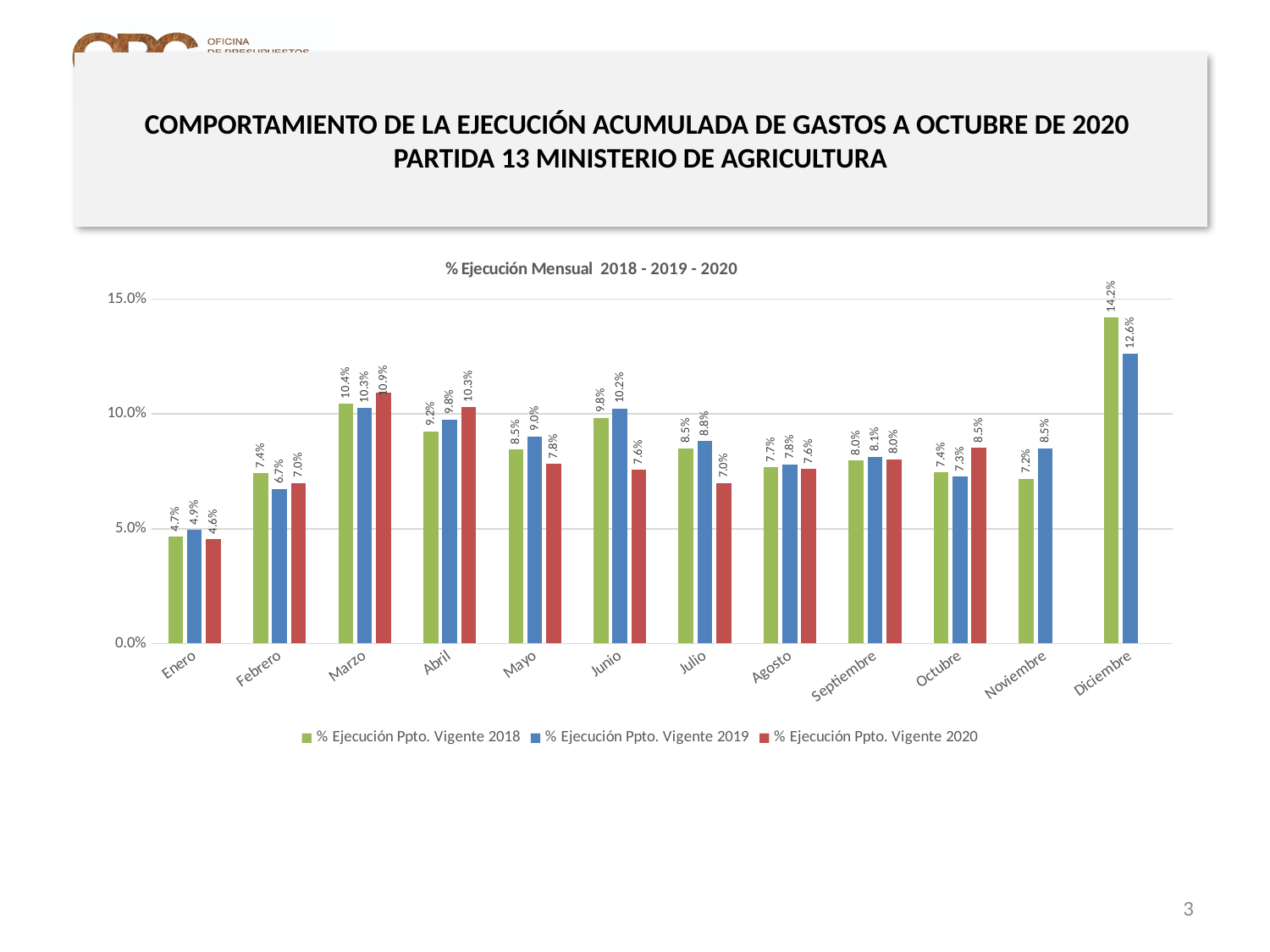
Which is larger for Octubre: the 2018 value or the 2020 value? 2020 value (8.5%) What is the value of % Ejecución Ppto. Vigente 2019 for Junio? 10.2% What is the title of the chart? % Ejecución Mensual 2018 - 2019 - 2020 Which month has the highest value for % Ejecución Ppto. Vigente 2019? Diciembre What kind of chart is shown on the slide? Bar chart What is the value of % Ejecución Ppto. Vigente 2020 for Marzo? 10.9% Is the value of % Ejecución Ppto. Vigente 2018 for Marzo greater or less than 10.0%? greater Which month has the lowest value for % Ejecución Ppto. Vigente 2020? Enero What is the value of % Ejecución Ppto. Vigente 2018 for Diciembre? 14.2% What is the difference between the 2018 and 2019 values for Diciembre? 1.6% How many months are shown on the x axis? 12 How many series does the legend list? 3